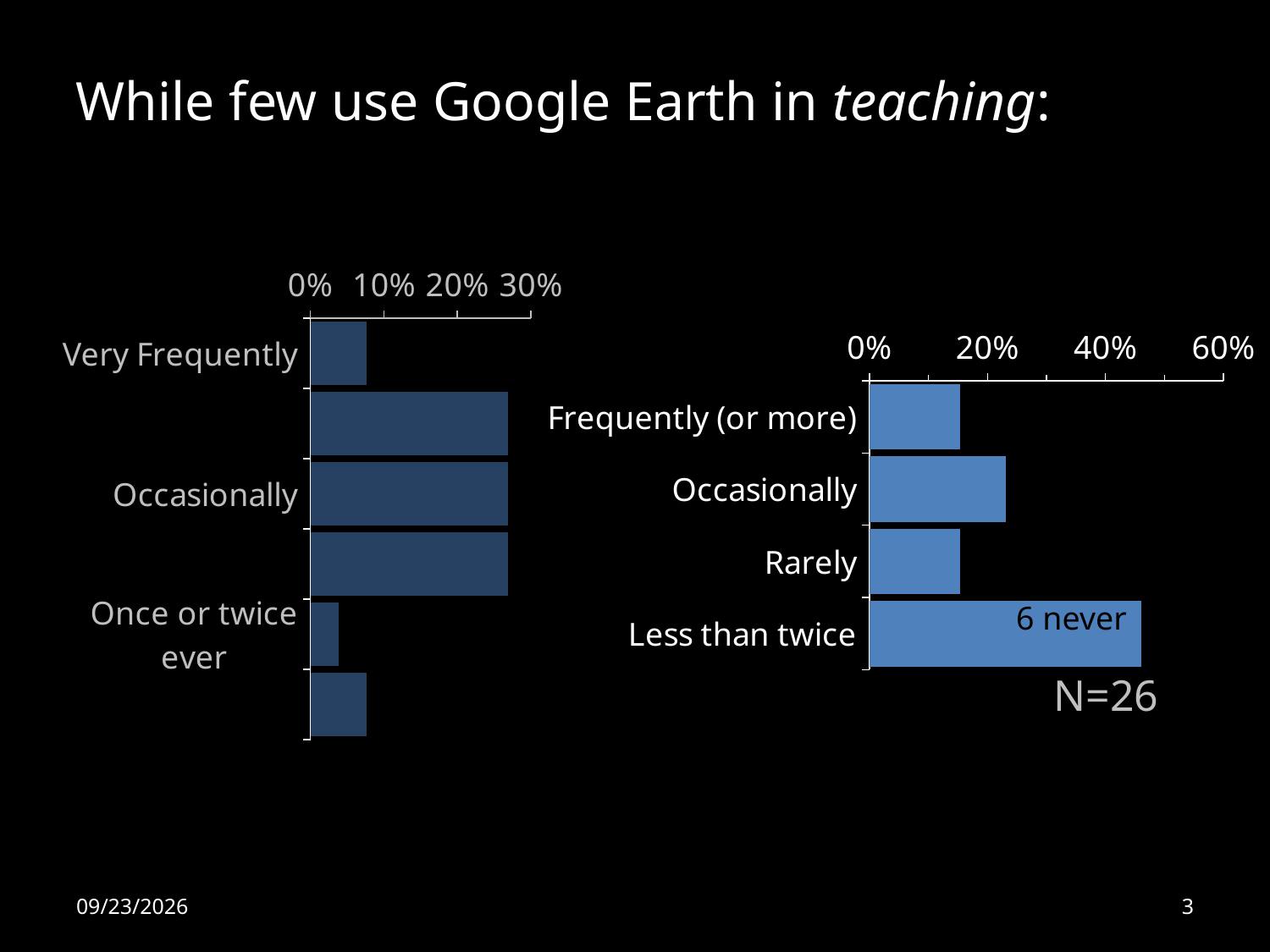
What sample size (N) is noted next to the chart on the right? N=26 In the chart on the left, is the value for Occasionally greater or less than 20%? greater In the chart on the right, is the value for Occasionally greater or less than 20%? greater In the chart on the left, is the value for Very Frequently greater or less than 10%? less What annotation is printed on the Less than twice bar in the chart on the right? 6 never What kind of chart is the chart on the right of the slide? bar chart In the chart on the left, which is larger, Occasionally or Once or twice ever? Occasionally How many categories are shown in the chart on the right? 4 In the chart on the right, which category has the highest value? Less than twice In the chart on the right, which is larger, Occasionally or Rarely? Occasionally